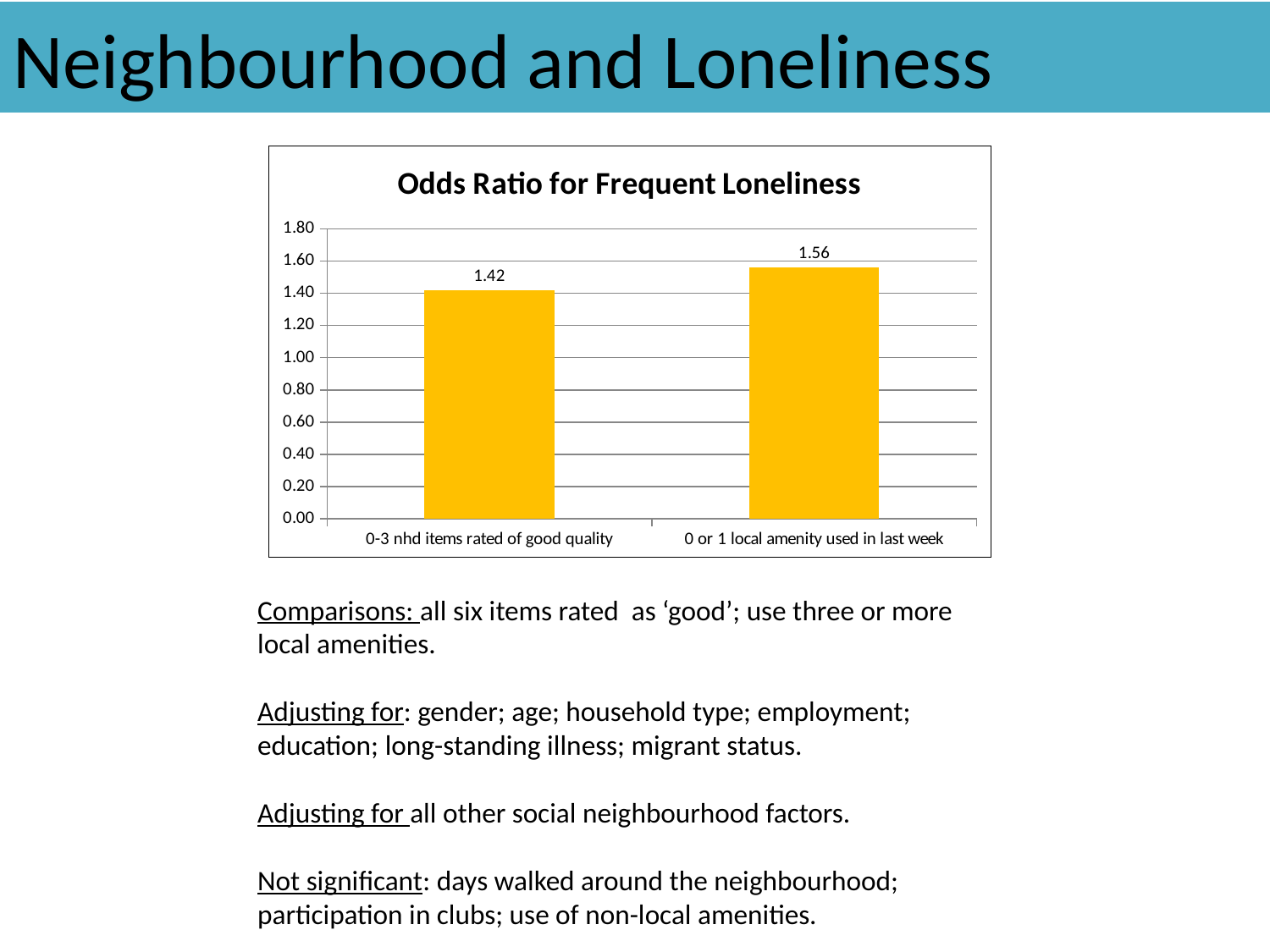
What is the difference between the odds ratios for '0 or 1 local amenity used in last week' and '0-3 nhd items rated of good quality'? 0.14 Is the odds ratio for '0 or 1 local amenity used in last week' greater or less than 1.40? greater What is the odds ratio for '0 or 1 local amenity used in last week'? 1.56 What is the title of the chart? Odds Ratio for Frequent Loneliness Is the odds ratio for '0-3 nhd items rated of good quality' greater or less than 1.60? less What is the odds ratio for '0-3 nhd items rated of good quality'? 1.42 What is the maximum value shown on the vertical axis of the chart? 1.80 Is the odds ratio for '0-3 nhd items rated of good quality' larger or smaller than that for '0 or 1 local amenity used in last week'? smaller What type of chart is shown on the slide? bar chart How many categories are shown in the chart? 2 Which category has the lower odds ratio for frequent loneliness? 0-3 nhd items rated of good quality Which category has the higher odds ratio for frequent loneliness? 0 or 1 local amenity used in last week